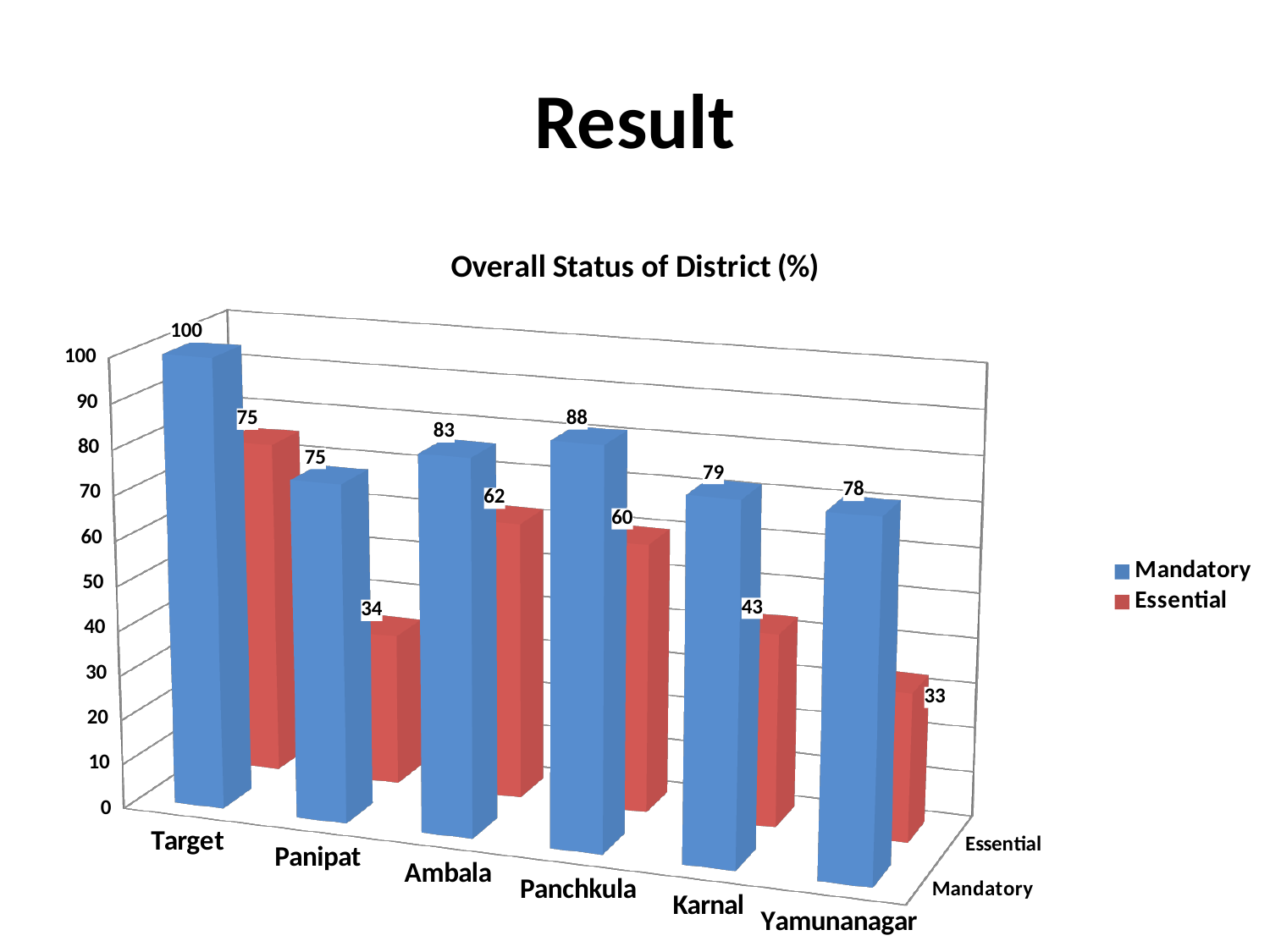
Which category has the highest Mandatory value? Target What is the Essential value for Panipat? 34 What kind of chart is shown? Bar chart How many series does the legend list? 2 How many categories are shown on the x axis? 6 What is the Mandatory value for Ambala? 83 Which is larger, the Essential value for Ambala or the Essential value for Panchkula? Ambala What is the title of the chart? Overall Status of District (%) What is the Essential value for Yamunanagar? 33 Which colour represents the Essential series? Red Which district has the lowest Essential value? Yamunanagar What is the difference between the Mandatory and Essential values for Karnal? 36